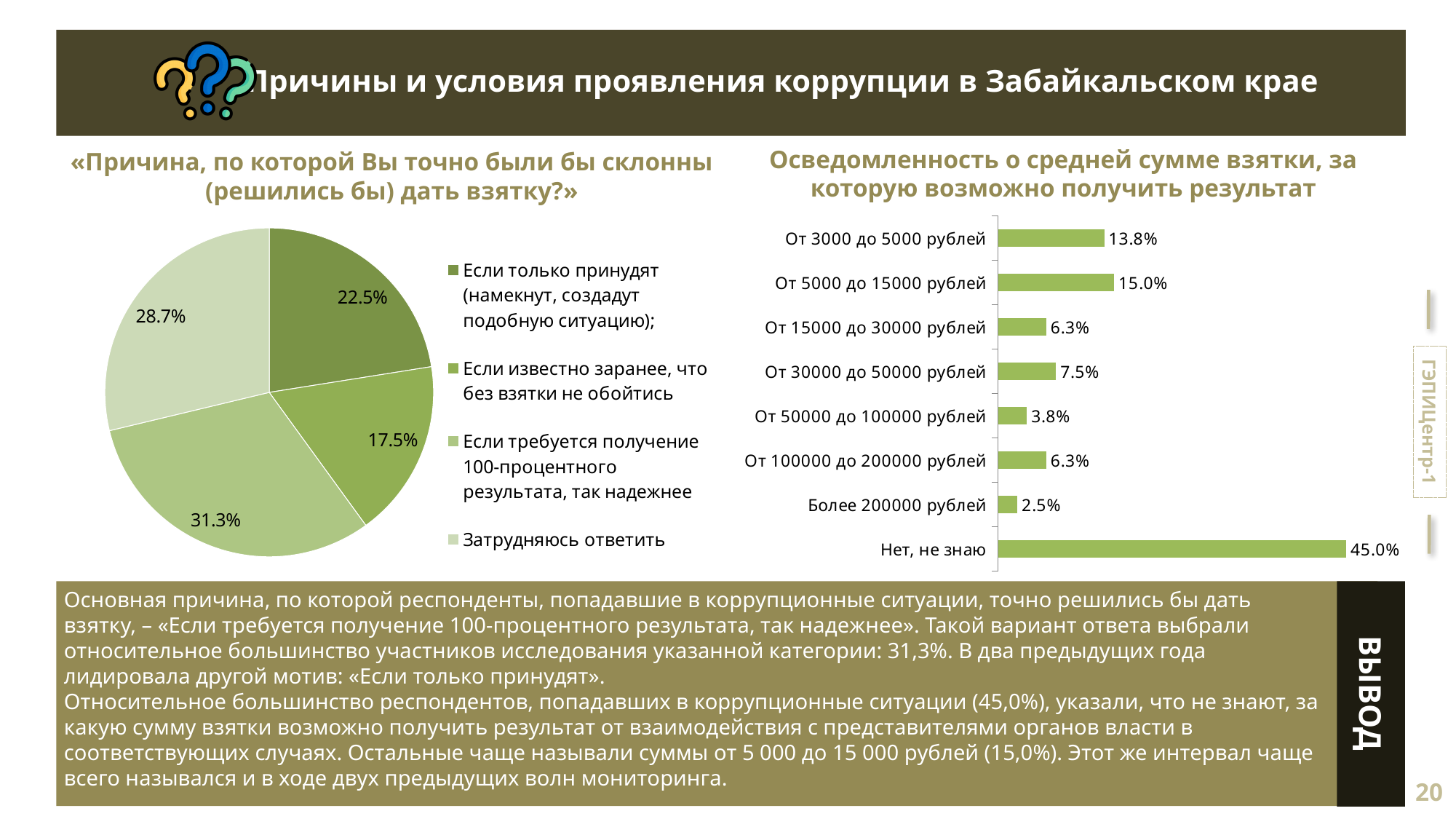
On the bar chart on the right, what is the value for «Более 200000 рублей»? 2.5% On the bar chart on the right, which category has the highest value? Нет, не знаю On the pie chart on the left, which category has the smallest slice? Если известно заранее, что без взятки не обойтись On the pie chart on the left, how many categories does the legend list? 4 On the pie chart on the left, what is the difference between the slice for «Если только принудят» and the slice for «Если известно заранее, что без взятки не обойтись»? 5.0% On the pie chart «Причина, по которой Вы точно были бы склонны (решились бы) дать взятку?», what share is shown for «Если требуется получение 100-процентного результата, так надежнее»? 31.3% What type of chart is shown on the right side of the slide? Bar chart On the pie chart on the left, what share is shown for «Затрудняюсь ответить»? 28.7% On the bar chart «Осведомленность о средней сумме взятки, за которую возможно получить результат», what is the value for «От 5000 до 15000 рублей»? 15.0% On the bar chart on the right, how many categories are plotted? 8 On the bar chart on the right, which category has the lowest value? Более 200000 рублей On the bar chart on the right, which is larger: the value for «От 3000 до 5000 рублей» or the value for «От 30000 до 50000 рублей»? От 3000 до 5000 рублей